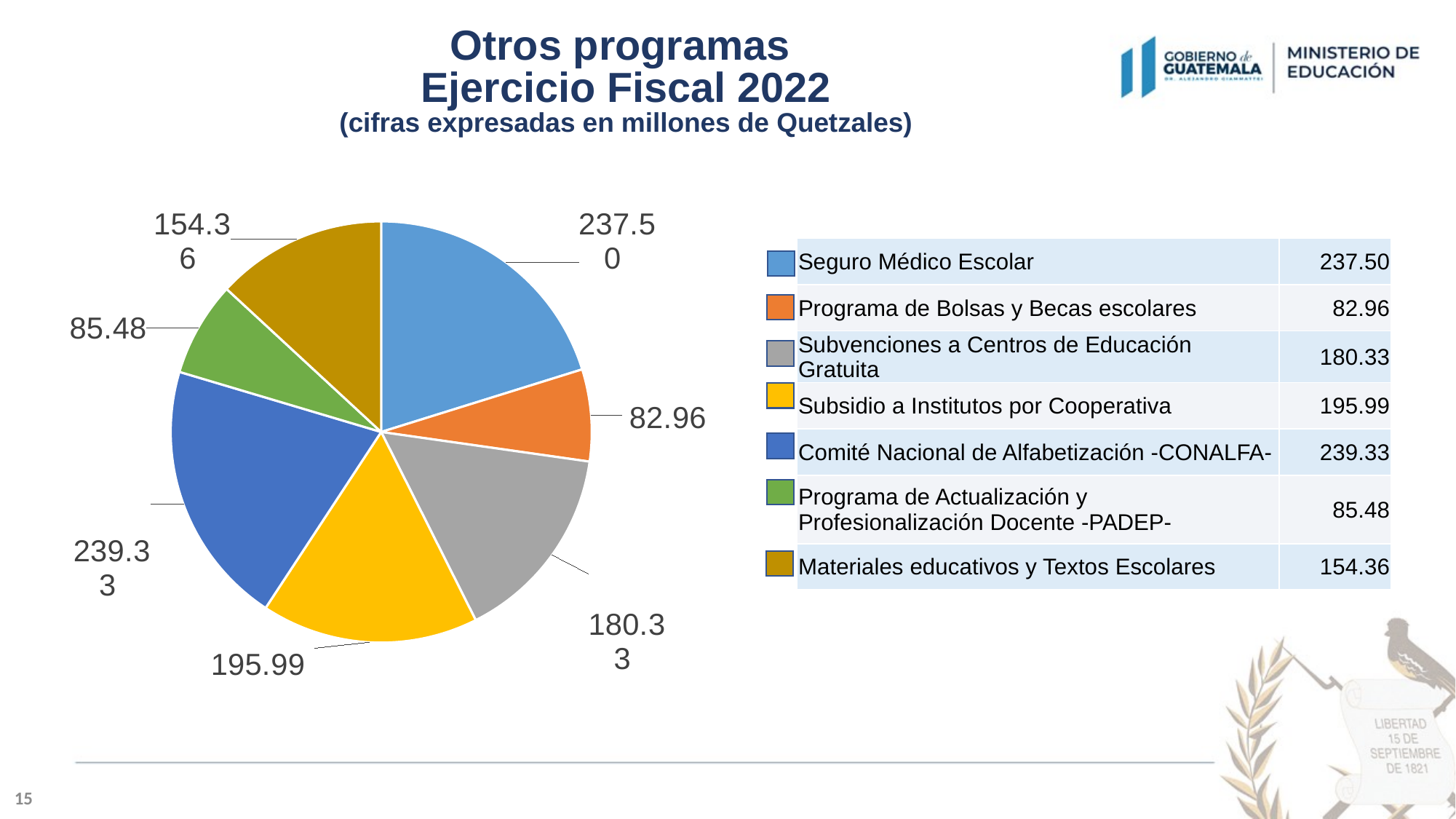
What is the value for Seguro Médico Escolar? 237.50 Which is larger, the value for Materiales educativos y Textos Escolares or the value for Programa de Actualización y Profesionalización Docente -PADEP-? Materiales educativos y Textos Escolares What is the value for Subsidio a Institutos por Cooperativa? 195.99 In what unit are the figures on the slide expressed, according to the title? Millones de Quetzales What is the difference between the values for Subsidio a Institutos por Cooperativa and Subvenciones a Centros de Educación Gratuita? 15.66 What is the value for Materiales educativos y Textos Escolares? 154.36 What kind of chart is shown on the slide? Pie chart How many slices does the pie chart have? 7 Which program has the lowest value in the pie chart? Programa de Bolsas y Becas escolares What colour is the slice for Subsidio a Institutos por Cooperativa? Yellow Which program has the highest value in the pie chart? Comité Nacional de Alfabetización -CONALFA- What is the difference between the values for Comité Nacional de Alfabetización -CONALFA- and Seguro Médico Escolar? 1.83